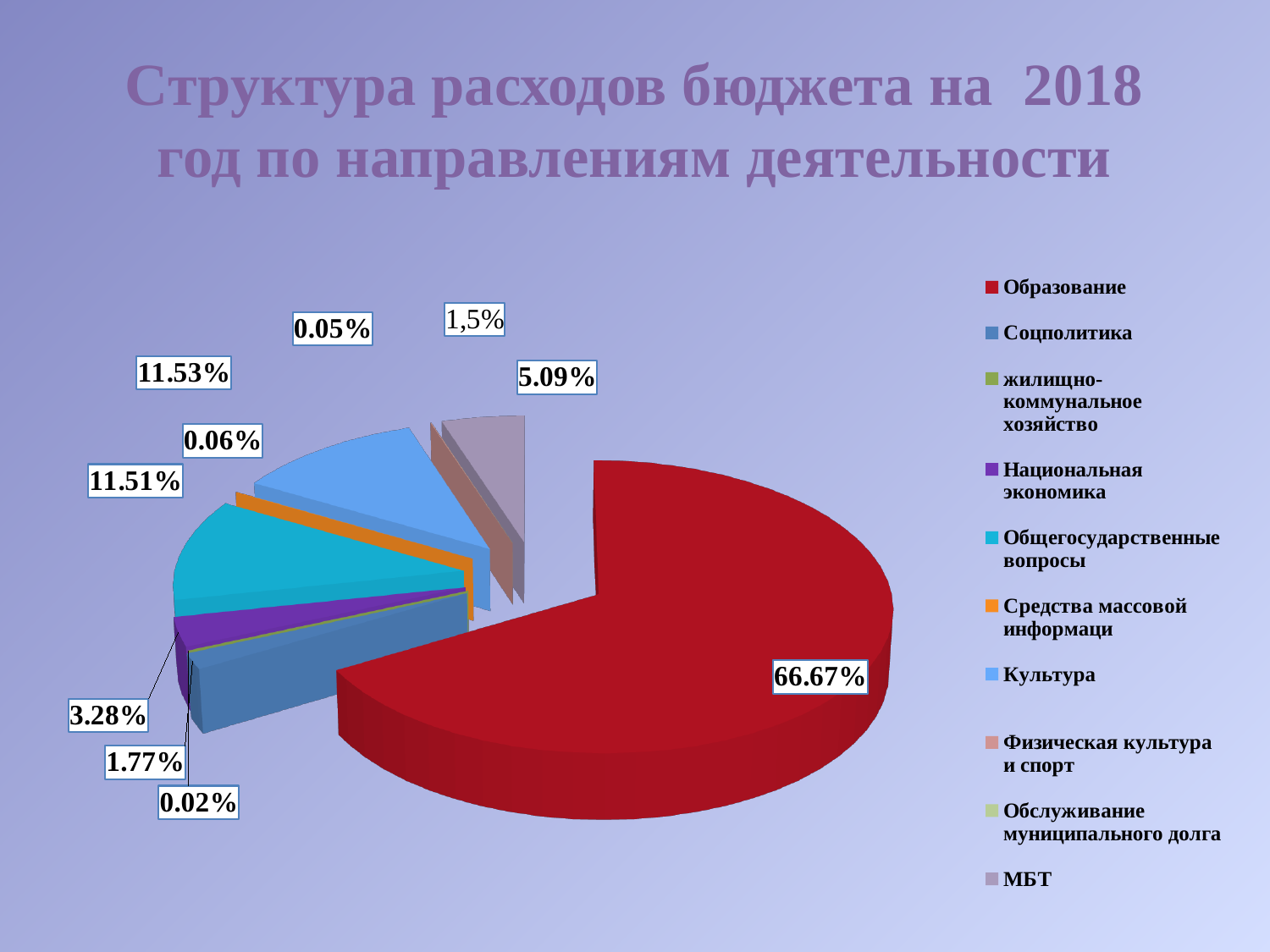
What colour is the Образование slice in the pie chart? red How many percentage data labels are shown around the pie chart? 10 What kind of chart is shown on the slide? pie chart Which is larger in the pie chart, Образование or Культура? Образование Which is larger in the pie chart, Образование or Соцполитика? Образование What share of the pie does Образование account for? 66.67% Which category has the largest slice of the pie chart? Образование What value is printed on the largest (red) slice of the pie chart? 66.67% How many categories does the legend of the pie chart list? 10 What is the title of the chart on the slide? Структура расходов бюджета на 2018 год по направлениям деятельности